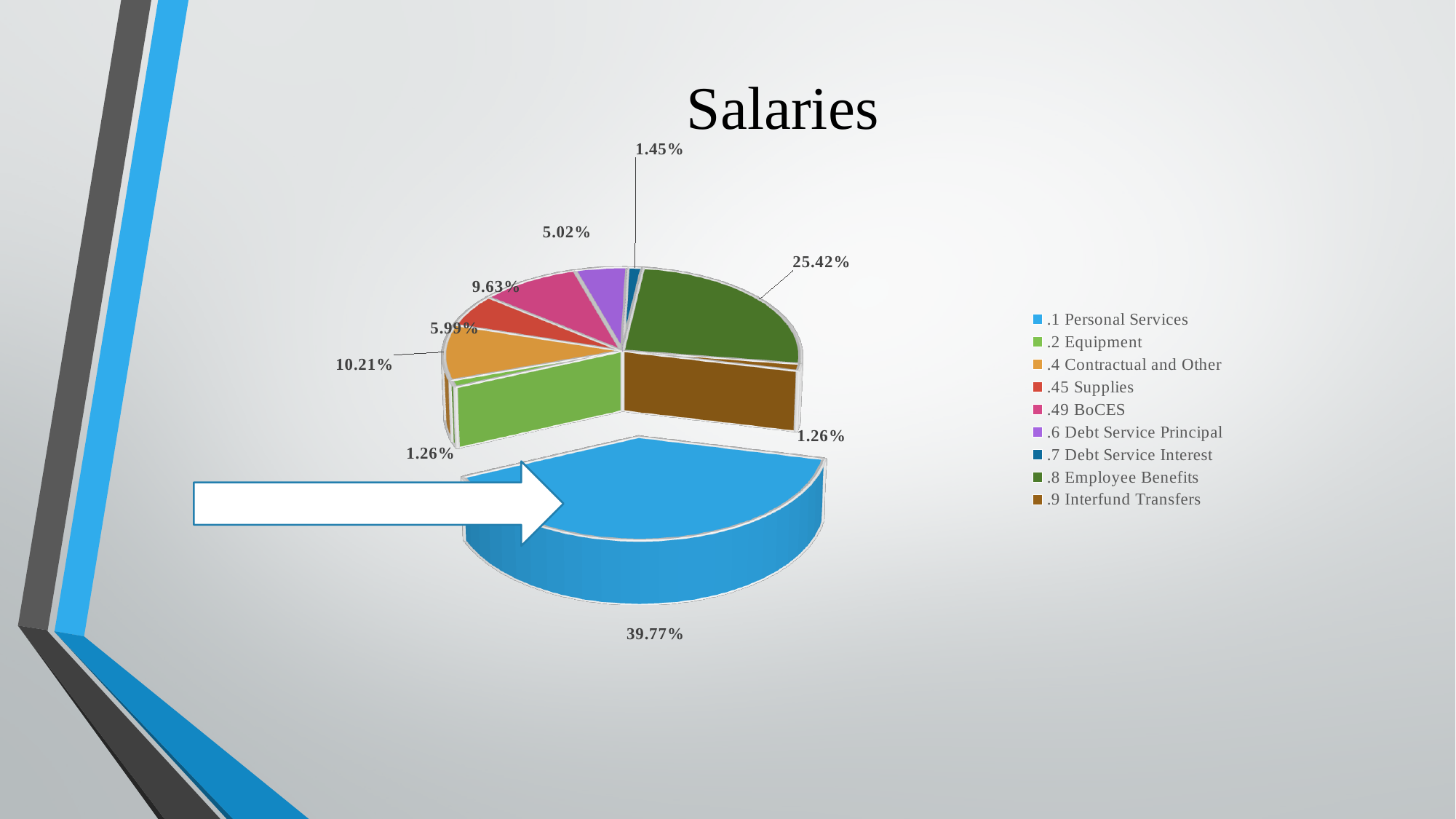
Is the share for .8 Employee Benefits greater or less than 20%? greater What percentage share does .1 Personal Services have in the pie? 39.77% What type of chart is shown on the slide? pie chart What is the title of the chart? Salaries Which is larger, the slice for .1 Personal Services or the slice for .8 Employee Benefits? .1 Personal Services How many categories does the legend list? 9 What is the smallest percentage value labelled on the pie? 1.26% What is the difference in percentage points between .1 Personal Services and .8 Employee Benefits? 14.35% Which category's slice is pulled out (exploded) from the rest of the pie? .1 Personal Services Which category has the largest slice of the pie? .1 Personal Services What percentage share does .8 Employee Benefits have in the pie? 25.42% What percentage share does .7 Debt Service Interest have in the pie? 1.45%